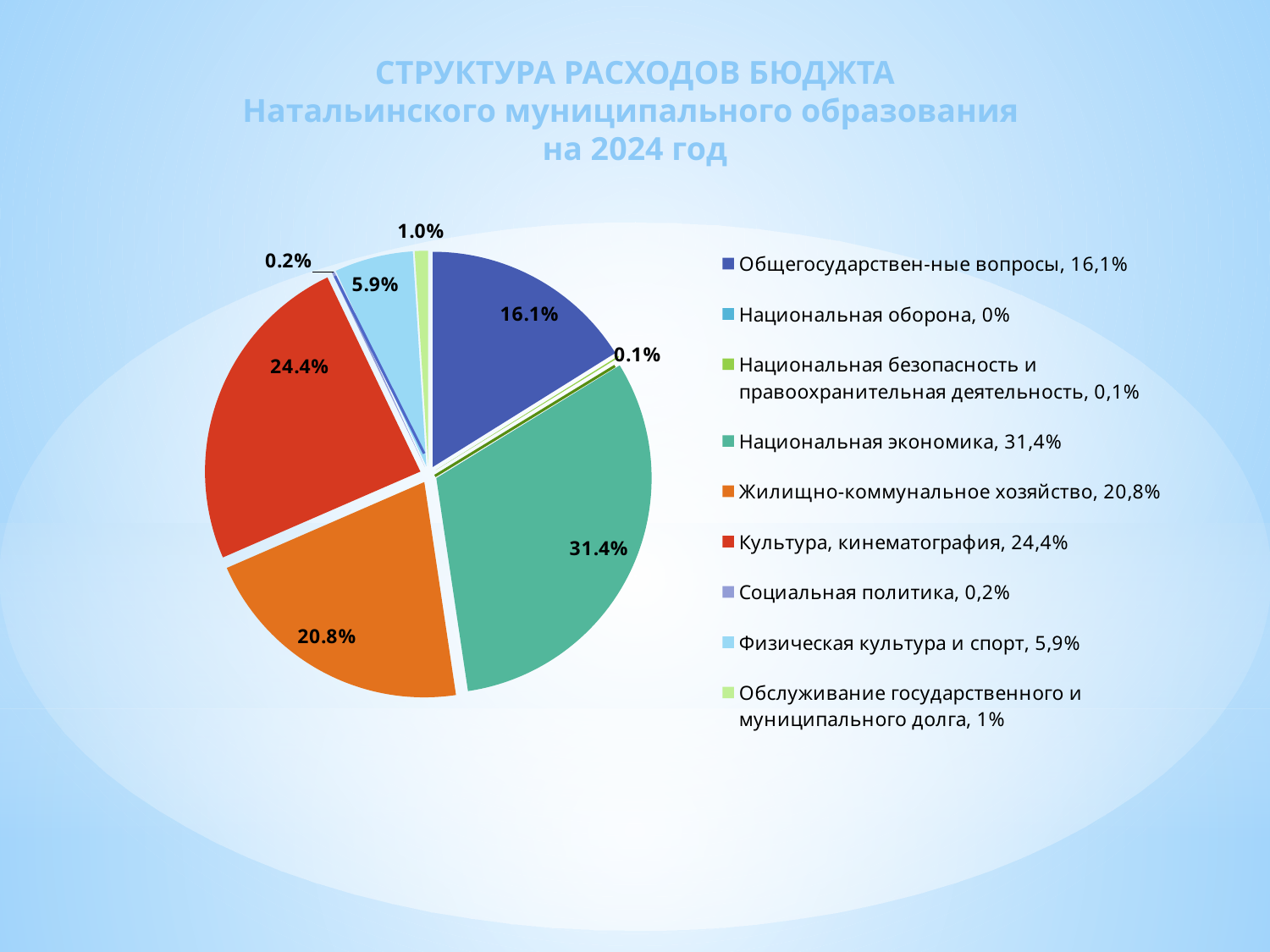
What share of the budget expenditure goes to Культура, кинематография? 24.4% What share of the budget expenditure goes to Национальная экономика? 31.4% What year does the chart title say the budget expenditure structure is for? 2024 What share of the budget expenditure goes to Физическая культура и спорт? 5.9% Which category has the smallest share of the budget expenditure? Национальная оборона What share of the budget expenditure goes to Общегосударственные вопросы? 16.1% What kind of chart is shown on the slide? pie chart Which has a larger share: Культура, кинематография or Общегосударственные вопросы? Культура, кинематография What share of the budget expenditure goes to Жилищно-коммунальное хозяйство? 20.8% Which category has the largest share of the budget expenditure? Национальная экономика How many categories does the legend list? 9 What is the difference in percentage points between the shares of Национальная экономика and Жилищно-коммунальное хозяйство? 10.6